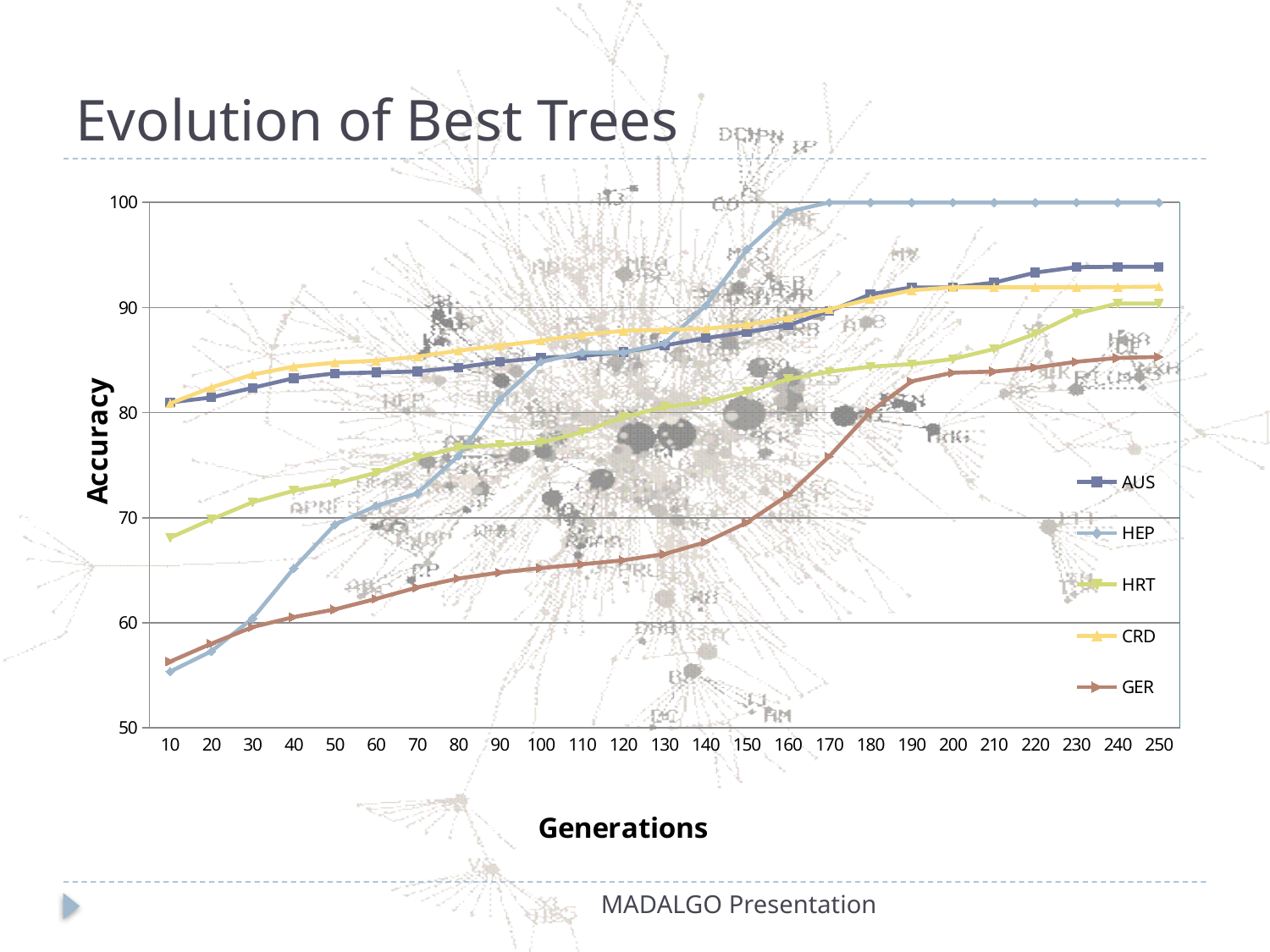
How many generation values are marked on the x axis? 25 How many series does the legend list? 5 What is the accuracy of HEP at generation 250? 100 Is the accuracy of GER at generation 10 greater or less than 60? less Which series has the highest accuracy at generation 250? HEP What kind of chart is shown on the slide? line chart Which series has the lowest accuracy at generation 250? GER Is the accuracy of AUS at generation 250 greater or less than 90? greater At generation 10, which series has higher accuracy, AUS or HRT? AUS Does the accuracy of HEP rise or fall as generations increase? rise What is the label of the y axis? Accuracy Is the accuracy of HRT at generation 10 greater or less than 70? less